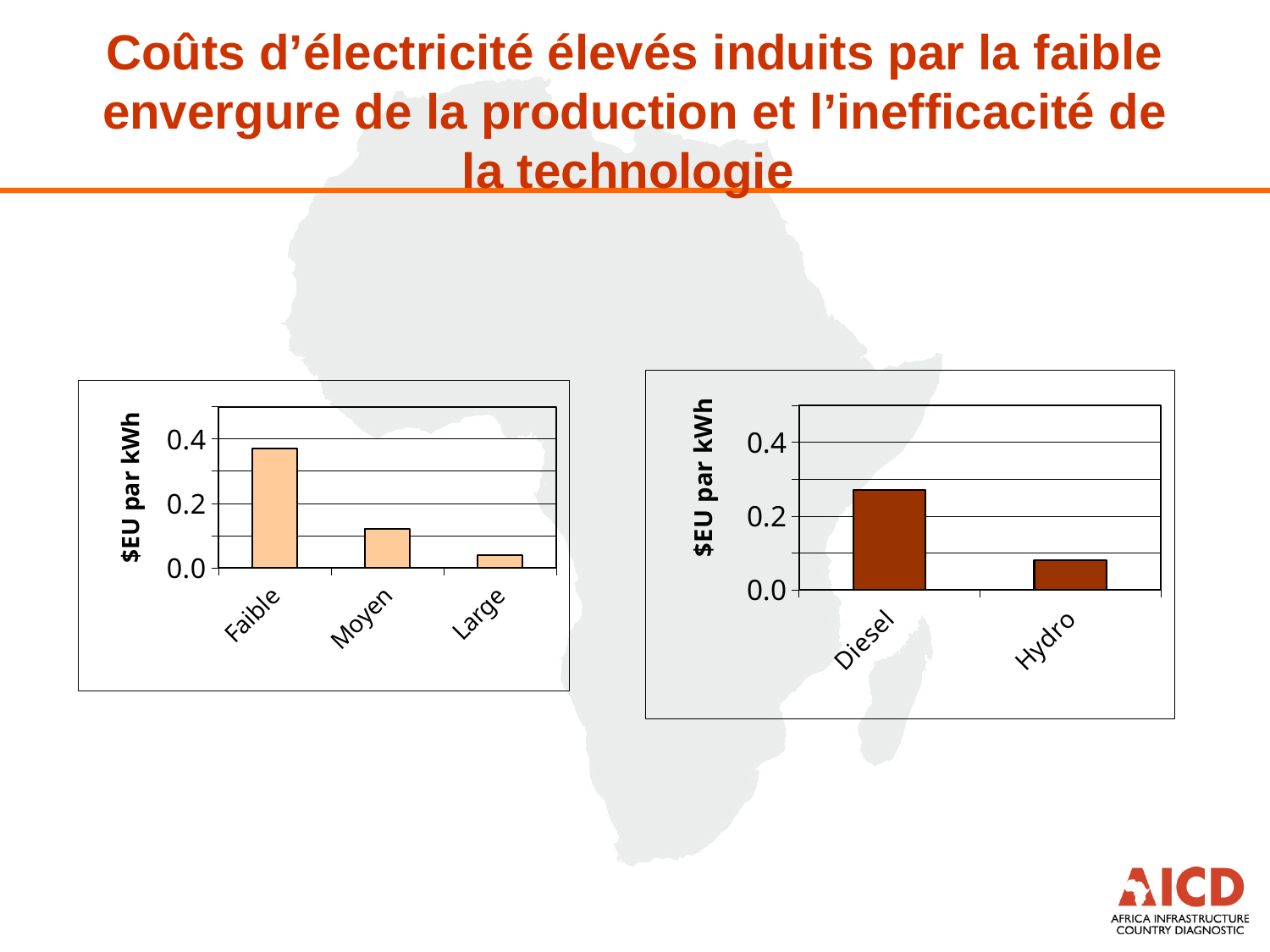
In the right chart (Diesel, Hydro), which category has the higher value? Diesel In the left chart (Faible, Moyen, Large), is the value for Moyen greater or less than 0.2? less In the left chart (Faible, Moyen, Large), what kind of chart is shown? bar chart In the left chart (Faible, Moyen, Large), do the values rise or fall from Faible to Large? fall In the right chart (Diesel, Hydro), how many categories are plotted? 2 In the right chart (Diesel, Hydro), what is the label on the vertical axis? $EU par kWh In the right chart (Diesel, Hydro), is the value for Hydro greater or less than 0.2? less In the left chart (Faible, Moyen, Large), which category has the lowest value? Large In the left chart (Faible, Moyen, Large), is the value for Faible greater or less than 0.2? greater In the left chart (Faible, Moyen, Large), how many categories are plotted? 3 In the left chart (Faible, Moyen, Large), which category has the highest value? Faible